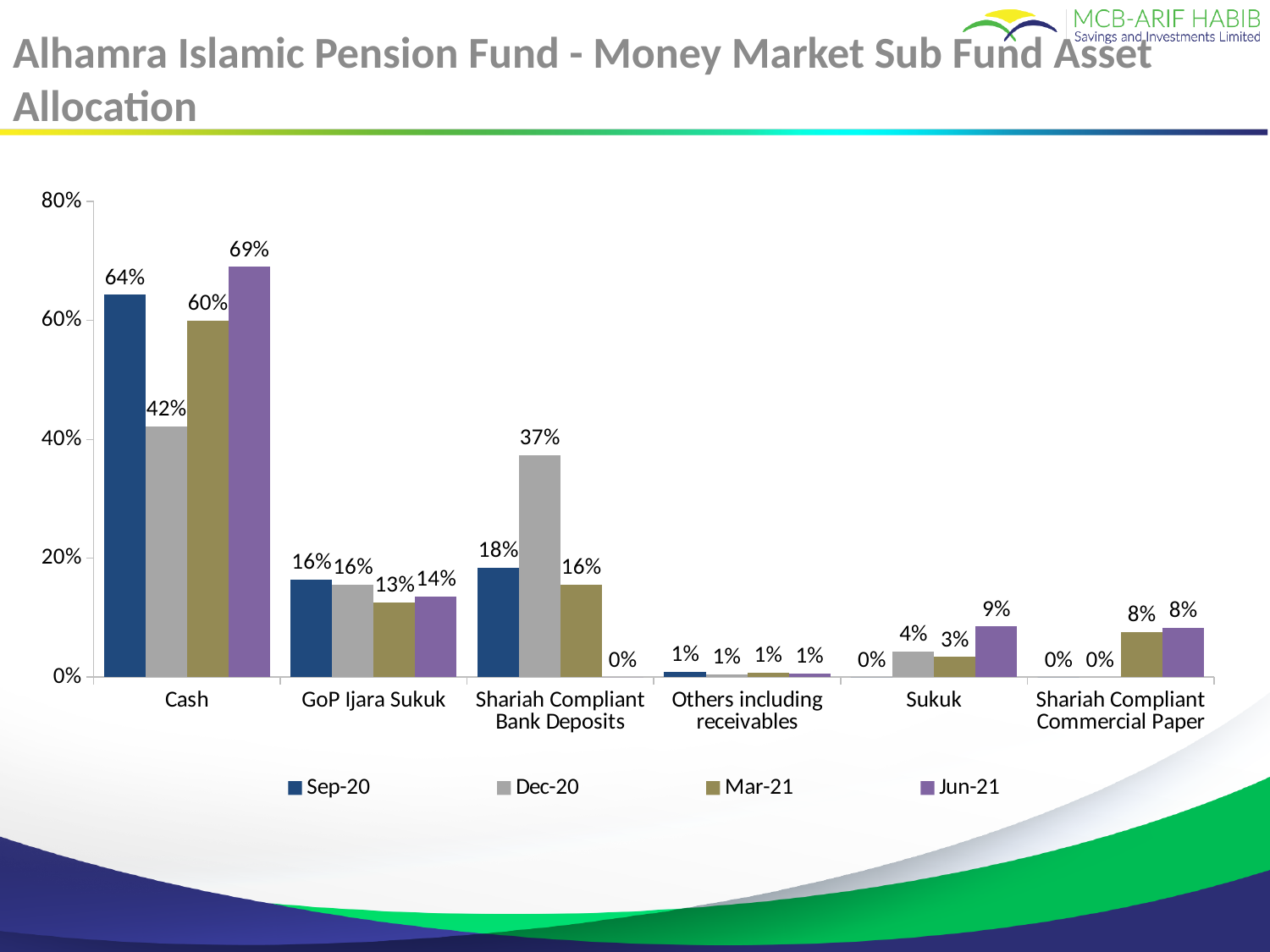
What is the Jun-21 value for Sukuk? 9% What is the Jun-21 value for Cash? 69% What is the difference between the Sep-20 and Dec-20 values for Cash? 22% What is the Mar-21 value for GoP Ijara Sukuk? 13% What kind of chart is shown on the slide? Bar chart Which period has the highest value for Cash? Jun-21 How many series does the legend list? 4 Which period has the lowest value for Cash? Dec-20 How many asset categories are shown on the x axis? 6 What is the Dec-20 value for Shariah Compliant Bank Deposits? 37% Which is larger for Shariah Compliant Bank Deposits: the Sep-20 value or the Dec-20 value? Dec-20 What is the Mar-21 value for Shariah Compliant Commercial Paper? 8%